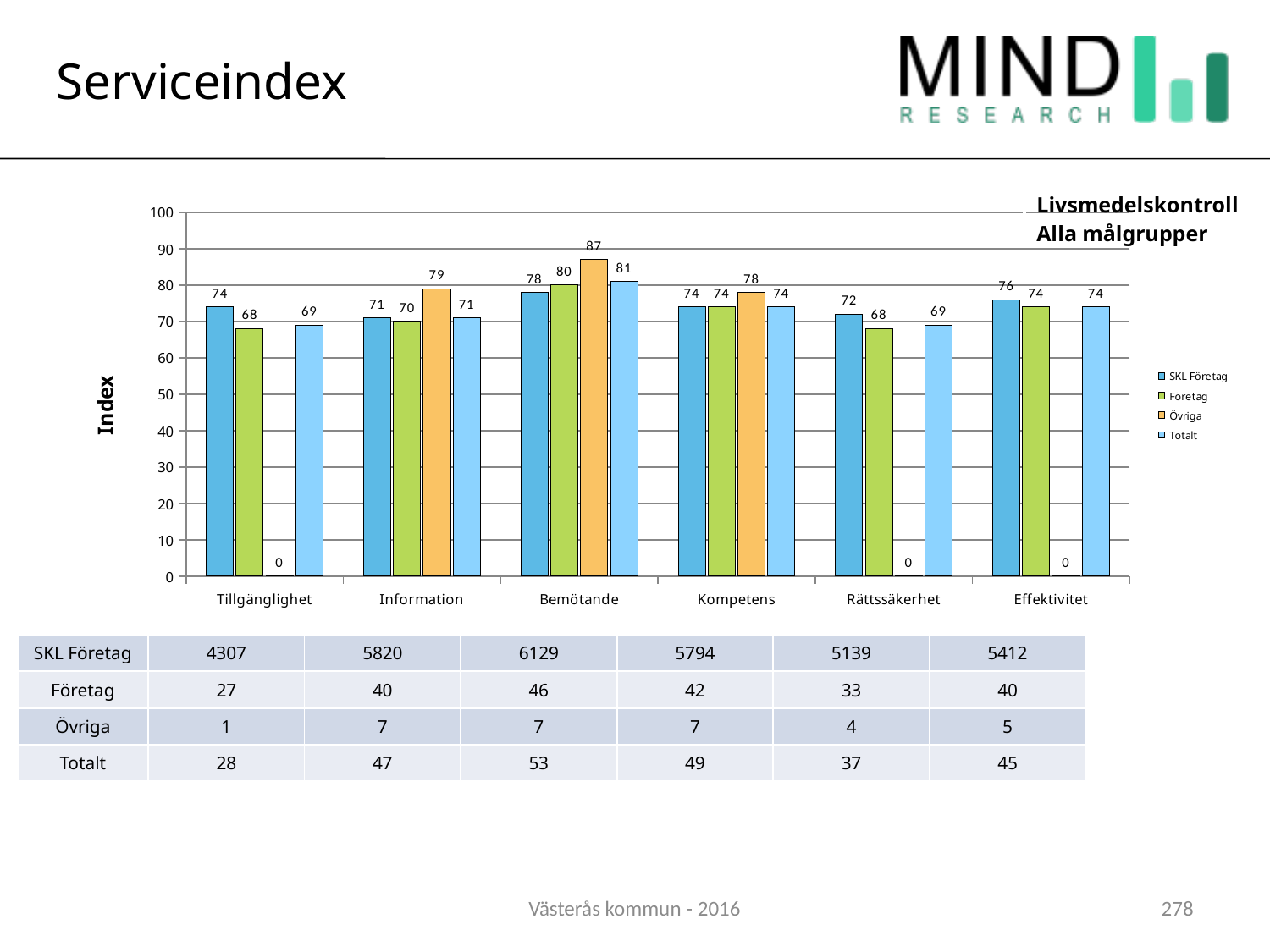
How many series does the chart legend list? 4 What is the difference between the Övriga value and the SKL Företag value in the Bemötande category? 9 What is the value for Övriga in the Bemötande category? 87 Which is larger in the Information category: the Övriga value or the Företag value? Övriga How many categories are shown on the x axis of the chart? 6 What kind of chart is shown on the slide? Bar chart What is the value for Företag in the Tillgänglighet category? 68 What is the value for SKL Företag in the Rättssäkerhet category? 72 What is the value for Totalt in the Information category? 71 What is the label on the vertical axis of the chart? Index In which category does the Totalt series reach its highest value? Bemötande In which category does the Företag series have its lowest value? Tillgänglighet and Rättssäkerhet (both 68)